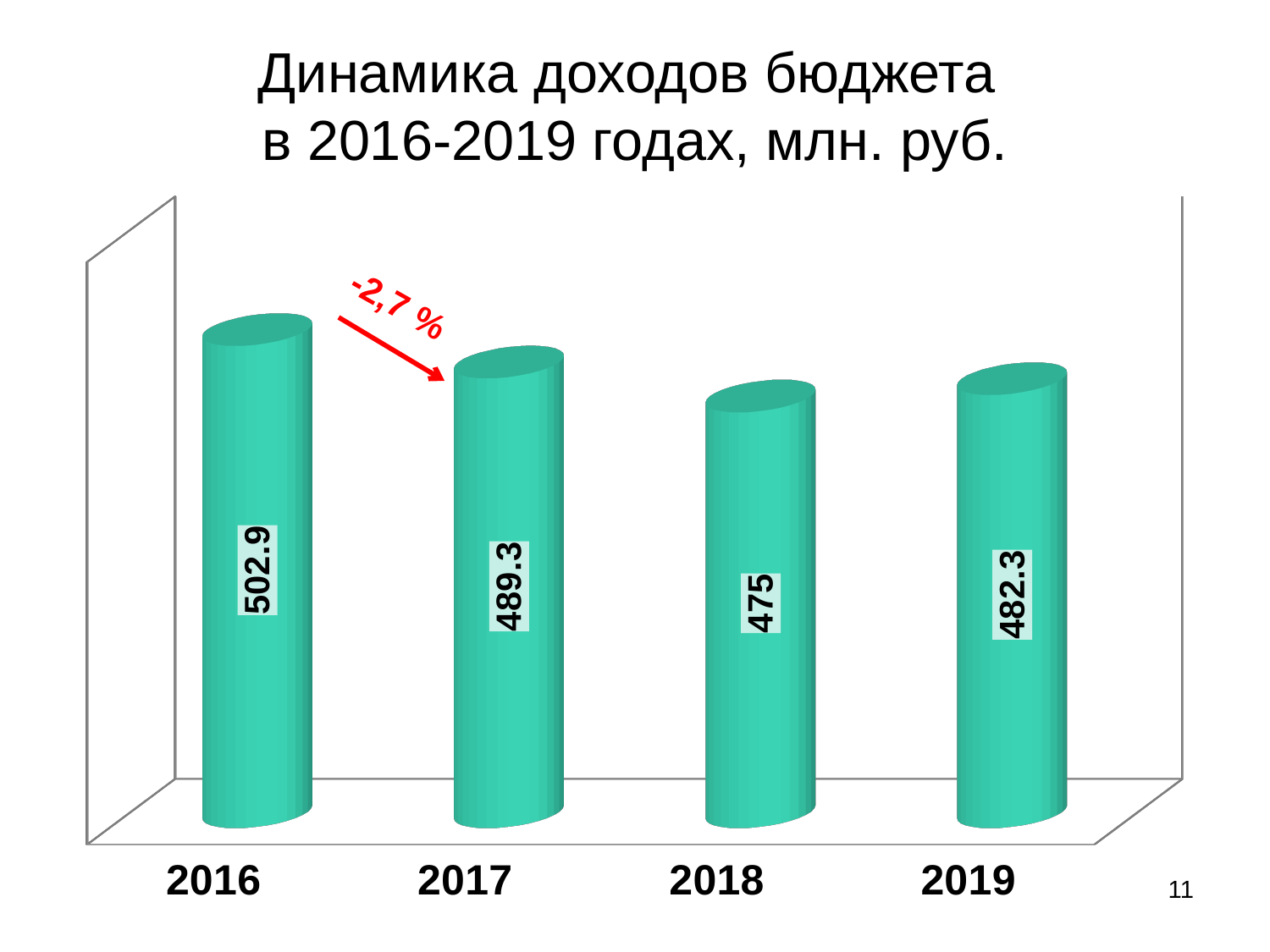
Which is larger, the value for 2017 or the value for 2019? 2017 Which year has the highest budget revenue? 2016 What is the budget revenue value for 2019? 482.3 What is the budget revenue value for 2016? 502.9 What is the budget revenue value for 2017? 489.3 What is the budget revenue value for 2018? 475 Which year has the lowest budget revenue? 2018 What is the difference between the 2016 and 2017 values? 13.6 What kind of chart is shown on the slide? Bar chart What percentage change is annotated in red between 2016 and 2017? -2,7 % How many years are shown on the chart? 4 What is the difference between the 2019 and 2018 values? 7.3